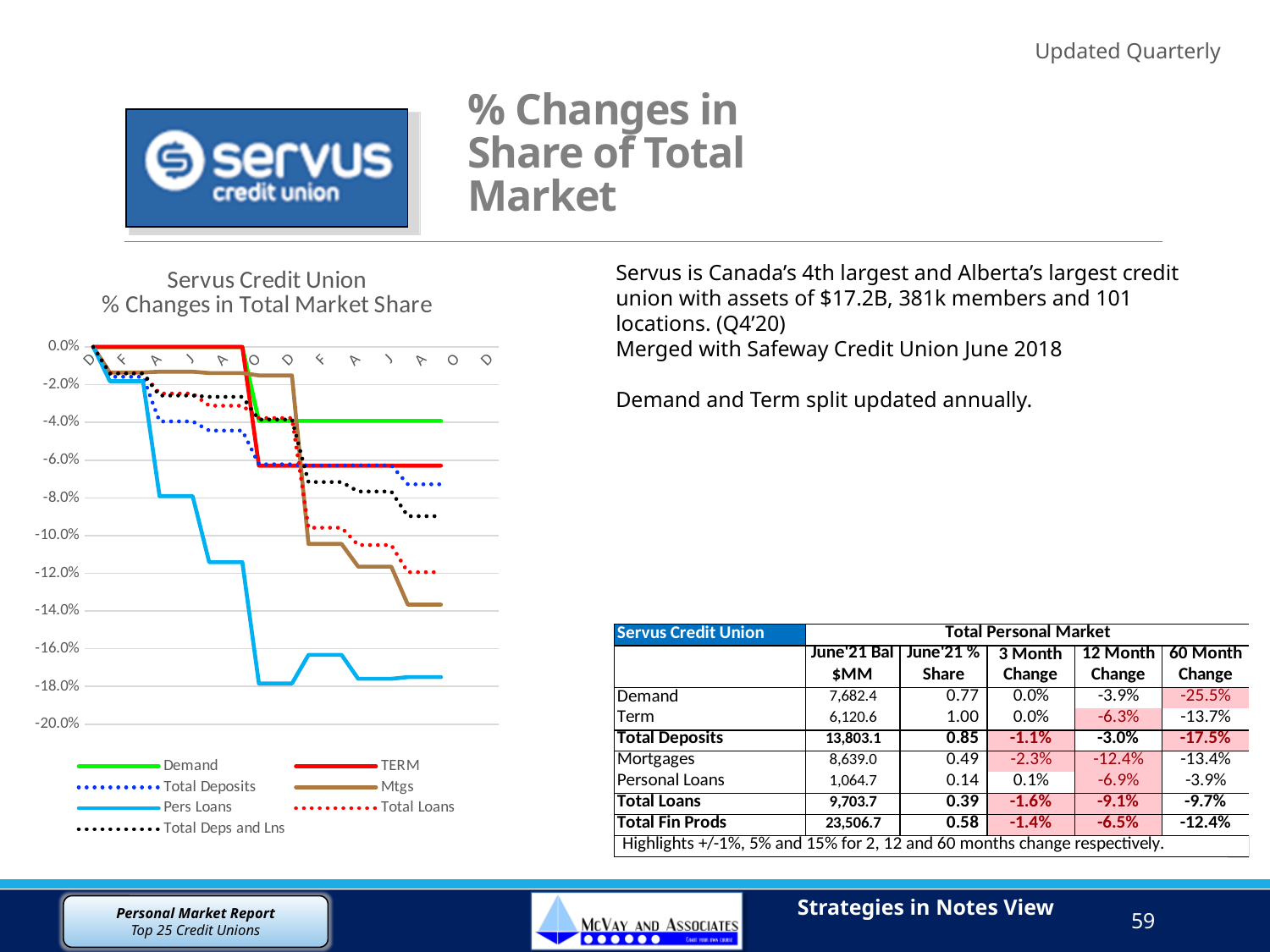
What kind of chart is shown on the slide? line chart Which series is plotted as the lowest line at the right end of the chart? Pers Loans Is the final value for Total Deps and Lns greater or less than -10.0%? greater Which series is plotted as the highest line at the right end of the chart? Demand Is the final value for Pers Loans greater or less than -16.0%? less Do the values for Pers Loans rise or fall along the x axis? fall Is the final value for Mtgs greater or less than -12.0%? less What is the title of the chart? Servus Credit Union % Changes in Total Market Share How many series does the chart legend list? 7 At the right end of the chart, which is larger, the value for Mtgs or the value for Pers Loans? Mtgs